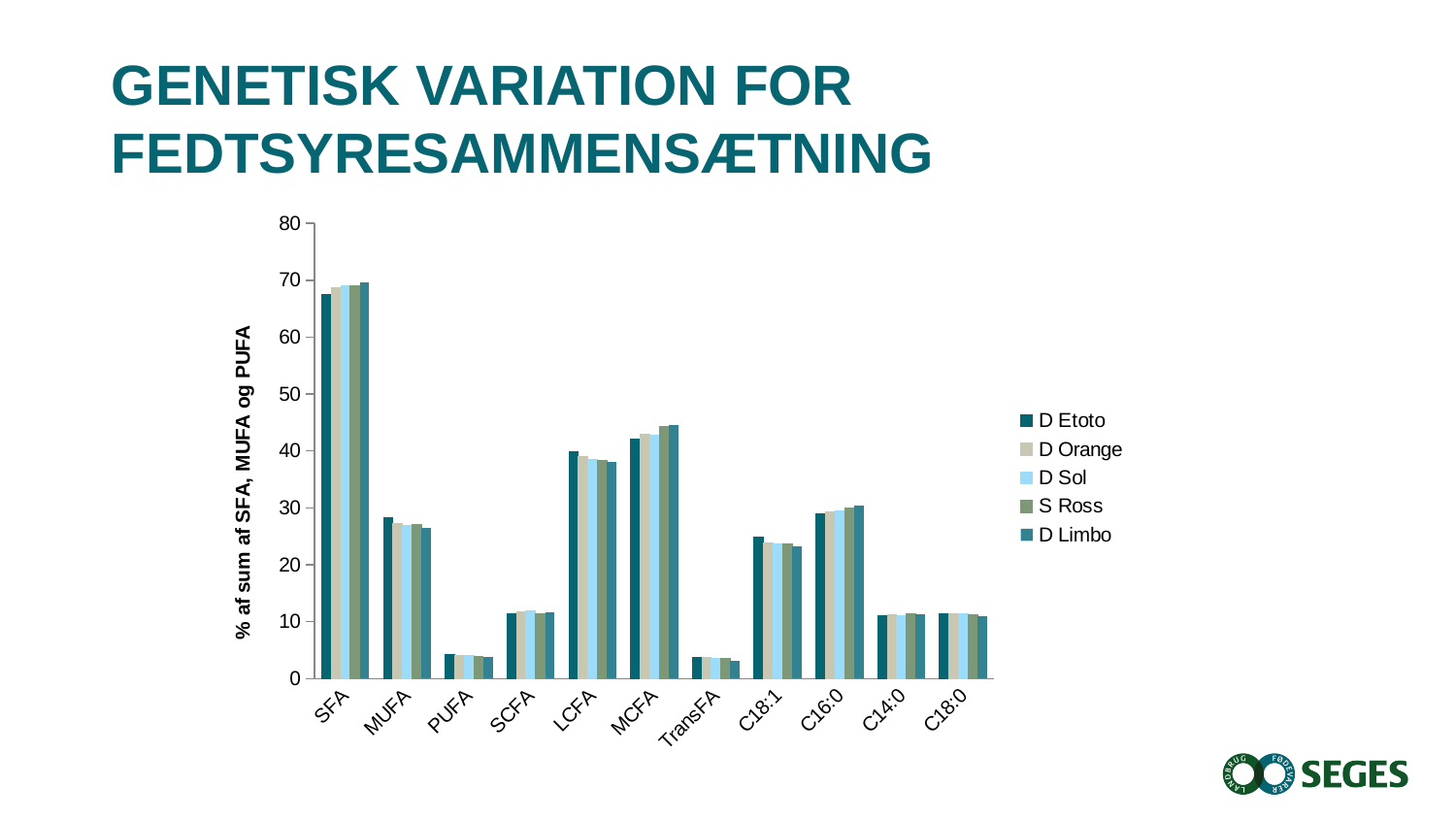
Which category has the highest values across all series? SFA Is the value for C18:1 in the D Etoto series greater or less than 20? greater Is the value for SFA in the D Etoto series greater or less than 60? greater What is the label on the y axis of the chart? % af sum af SFA, MUFA og PUFA Is the value for MCFA in the D Limbo series greater or less than 40? greater How many series does the legend list? 5 For the D Etoto series, which is larger: C18:1 or C16:0? C16:0 How many categories are shown on the x axis? 11 For the D Limbo series, which is larger: LCFA or MCFA? MCFA What kind of chart is shown on the slide? bar chart